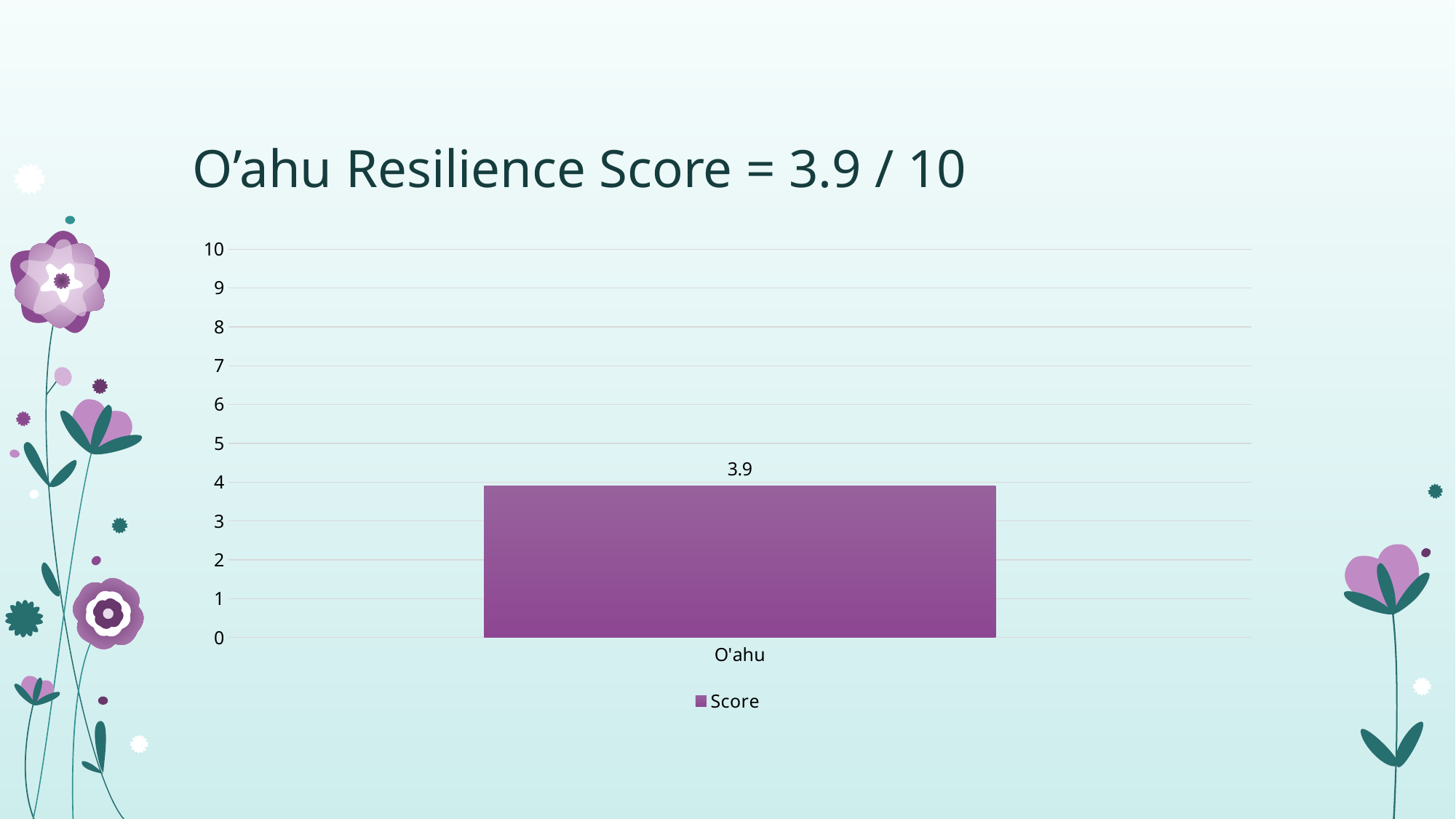
How many series does the legend list? 1 Is the value for O'ahu greater or less than 5? less What kind of chart is shown on the slide? bar chart What series name is listed in the legend? Score Is the value for O'ahu greater or less than 3? greater What is the Score value for O'ahu? 3.9 What is the maximum value shown on the y axis? 10 What is the title of the slide? O'ahu Resilience Score = 3.9 / 10 How many categories are shown on the x axis? 1